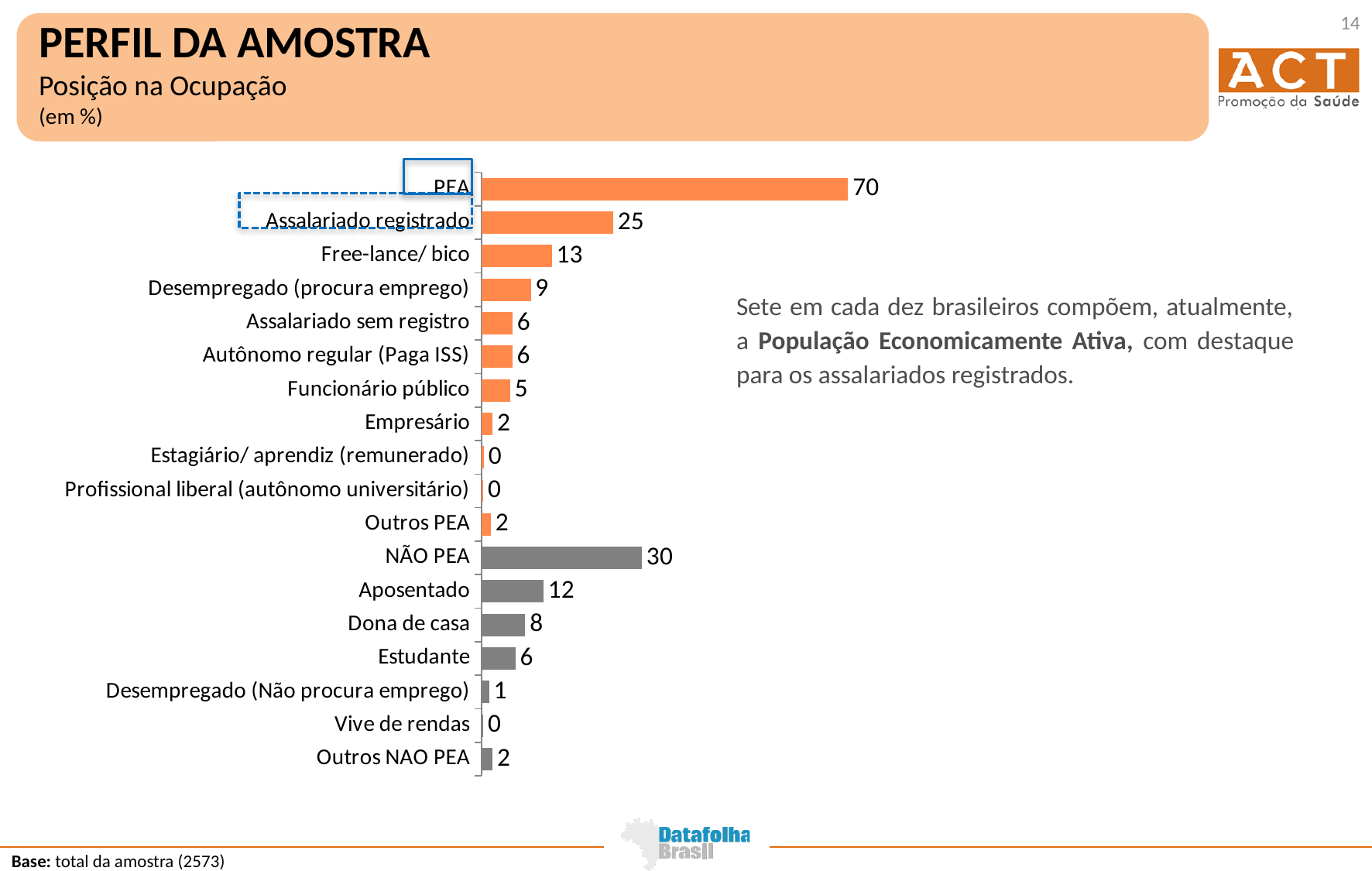
How many categories are shown on the chart? 18 What is the value for Aposentado? 12 What is the value for Assalariado registrado? 25 What is the value for Free-lance/ bico? 13 What is the difference between the values for PEA and NÃO PEA? 40 What is the value for NÃO PEA? 30 What is the value for PEA? 70 Which is larger, the value for Dona de casa or the value for Estudante? Dona de casa What is the difference between the values for Assalariado registrado and Free-lance/ bico? 12 What colour are the bars for the NÃO PEA categories? Grey Which category has the highest value? PEA What kind of chart is shown on the slide? Bar chart